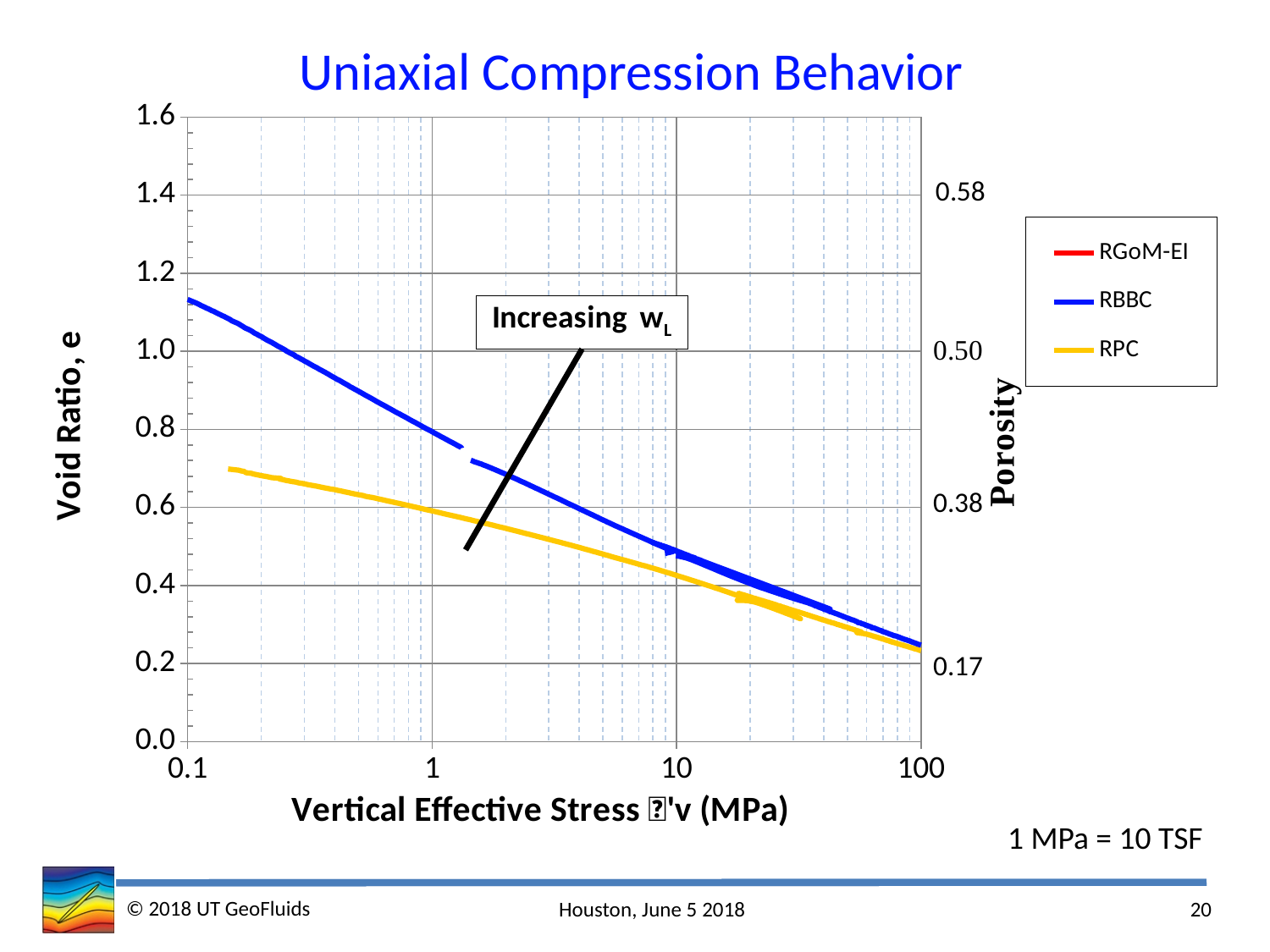
Does the void ratio of the RBBC series rise or fall as vertical effective stress increases? fall Is the void ratio of the RBBC series at 10 MPa greater or less than 0.6? less Is the void ratio of the RBBC series at 1 MPa greater or less than 0.6? greater How many series does the legend list? 3 Is the void ratio of the RBBC series at 0.1 MPa greater or less than 1.0? greater What kind of chart is shown on the slide? line chart Which series is drawn in blue according to the legend? RBBC Does the void ratio of the RPC series rise or fall as vertical effective stress increases? fall What is the title of the chart? Uniaxial Compression Behavior At a vertical effective stress of 1 MPa, which series has the higher void ratio, RBBC or RPC? RBBC